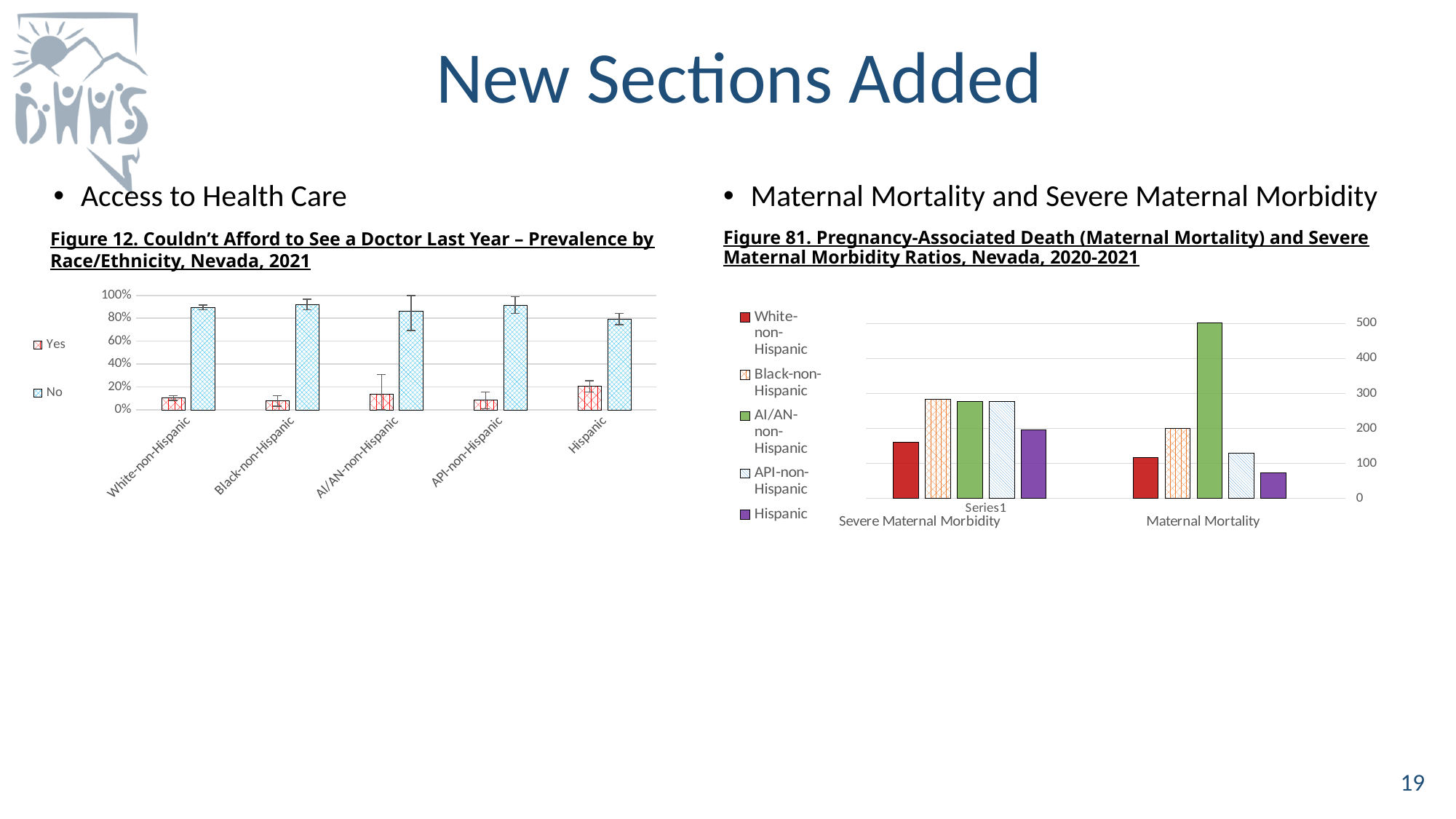
In Figure 81, which race/ethnicity has the lowest Maternal Mortality value? Hispanic In Figure 12, which is larger for White-non-Hispanic, the 'Yes' bar or the 'No' bar? No In Figure 81, which race/ethnicity has the highest Maternal Mortality value? AI/AN-non-Hispanic How many series does the legend of Figure 81 list? 5 In Figure 12, which race/ethnicity has the highest 'Yes' value? Hispanic In Figure 12, is the 'No' value for Black-non-Hispanic greater or less than 80%? greater How many race/ethnicity categories are shown on the x axis of Figure 12? 5 What kind of chart is Figure 12? bar chart In Figure 81, which is larger for Severe Maternal Morbidity, the Black-non-Hispanic bar or the White-non-Hispanic bar? Black-non-Hispanic In Figure 12, is the 'Yes' value for AI/AN-non-Hispanic greater or less than 20%? less How many series does the legend of Figure 12 list? 2 In Figure 81, is the Maternal Mortality value for AI/AN-non-Hispanic greater or less than 400? greater